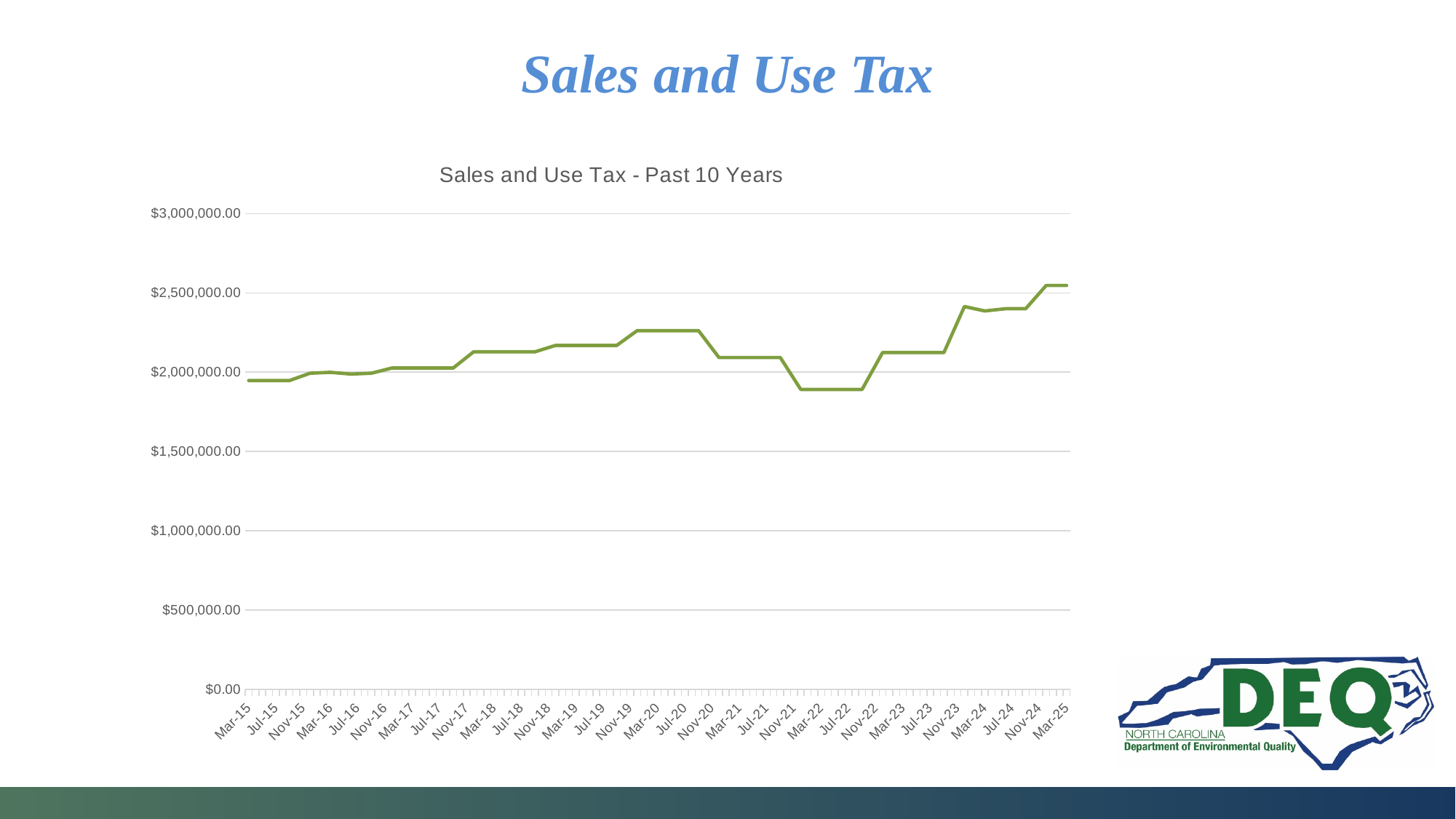
Which is larger, the value at Mar-20 or the value at Mar-22? Mar-20 Is the value for Mar-25 greater or less than $2,500,000.00? greater What kind of chart is shown on the slide? Line chart Is the value for Jul-22 greater or less than $2,000,000.00? less Is the value for Mar-22 greater or less than $2,000,000.00? less What is the title of the chart? Sales and Use Tax - Past 10 Years Which is larger, the value at Mar-15 or the value at Mar-25? Mar-25 Overall, does the line rise or fall from Mar-15 to Mar-25? Rises Which x-axis label has the highest value on the line? Mar-25 What colour is the line in the chart? Green